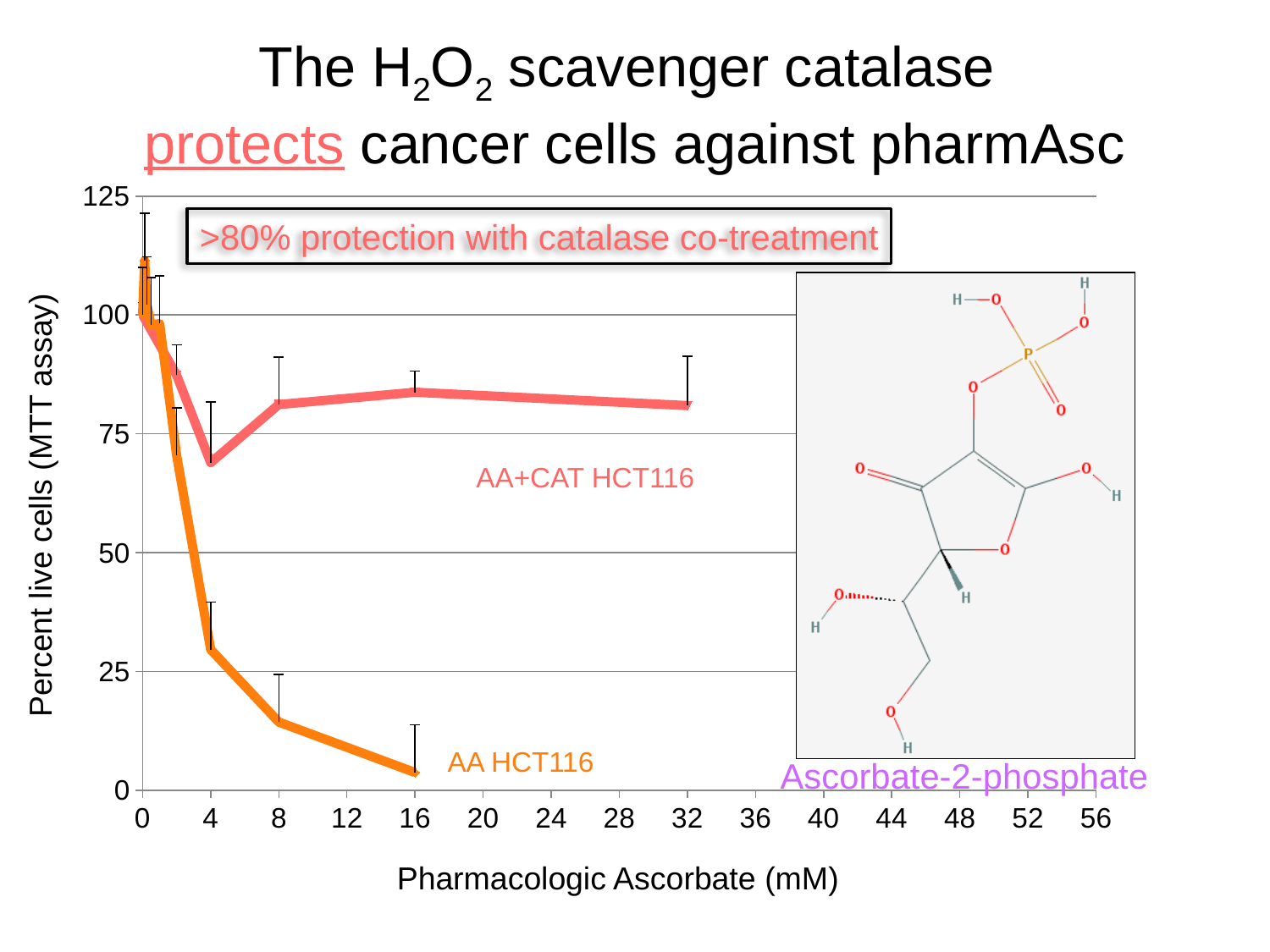
What is the label of the x axis? Pharmacologic Ascorbate (mM) How many data series are plotted on the chart? 2 Is the value for AA HCT116 at 16 mM greater or less than 25? less What is the label of the y axis? Percent live cells (MTT assay) At 16 mM, which series has the higher percent of live cells, AA HCT116 or AA+CAT HCT116? AA+CAT HCT116 Is the value for AA+CAT HCT116 at 32 mM greater or less than 75? greater Is the value for AA+CAT HCT116 at 16 mM greater or less than 75? greater What kind of chart is shown on the slide? line chart Does the AA HCT116 series rise or fall as the ascorbate concentration increases? fall